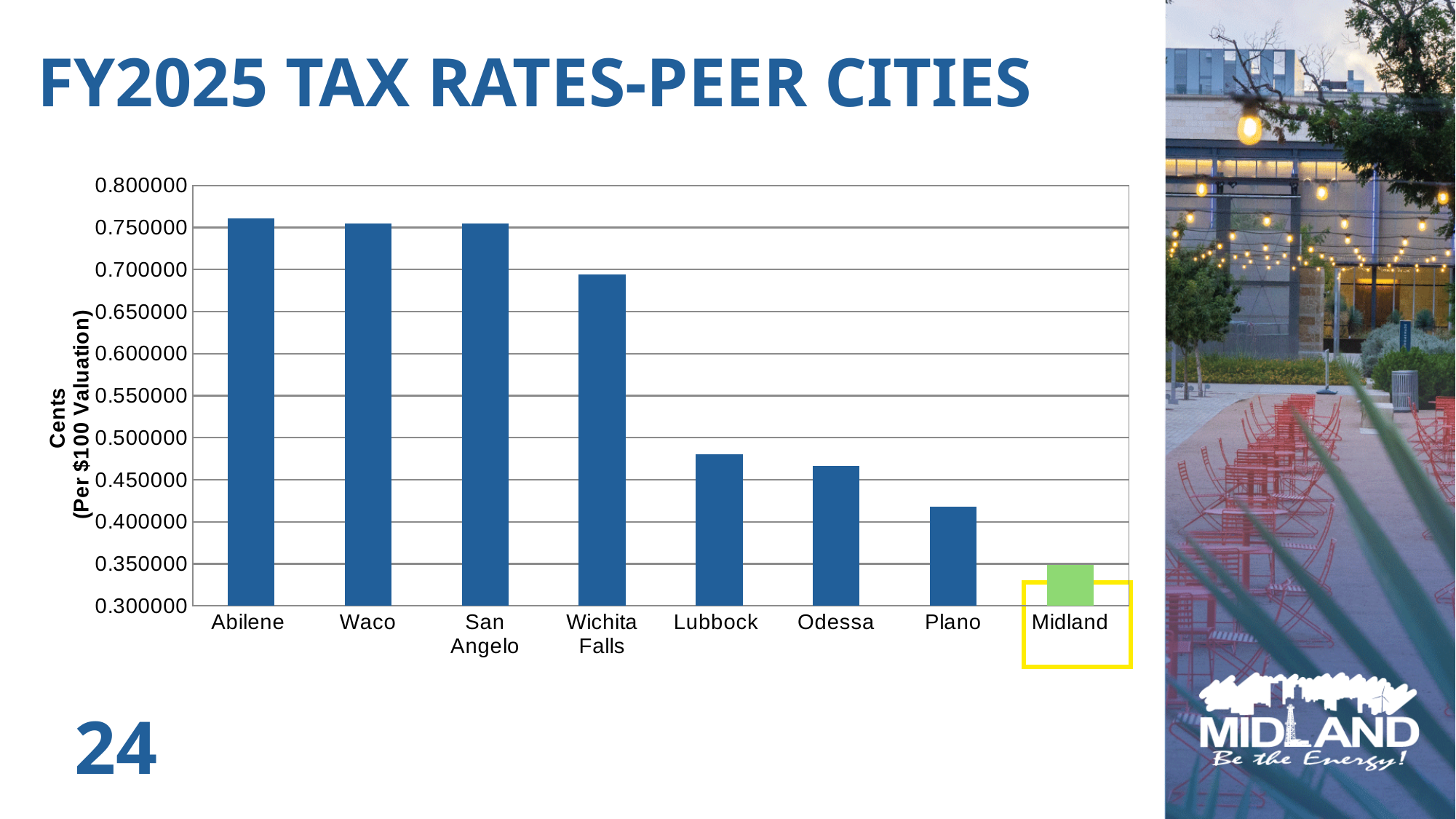
How many cities are shown on the x axis of the chart? 8 Which has the higher tax rate, Wichita Falls or Lubbock? Wichita Falls Is the value for Plano greater or less than 0.400000? greater Which city has the lowest tax rate in the chart? Midland Which has the higher tax rate, Odessa or Plano? Odessa Is the value for Abilene greater or less than 0.750000? greater Is the value for Wichita Falls greater or less than 0.700000? less Do the bar values generally rise or fall moving from left to right along the x axis? fall What kind of chart is shown on the slide? bar chart Which city's bar is coloured green and highlighted with a yellow box? Midland What is the label on the y axis of the chart? Cents (Per $100 Valuation)